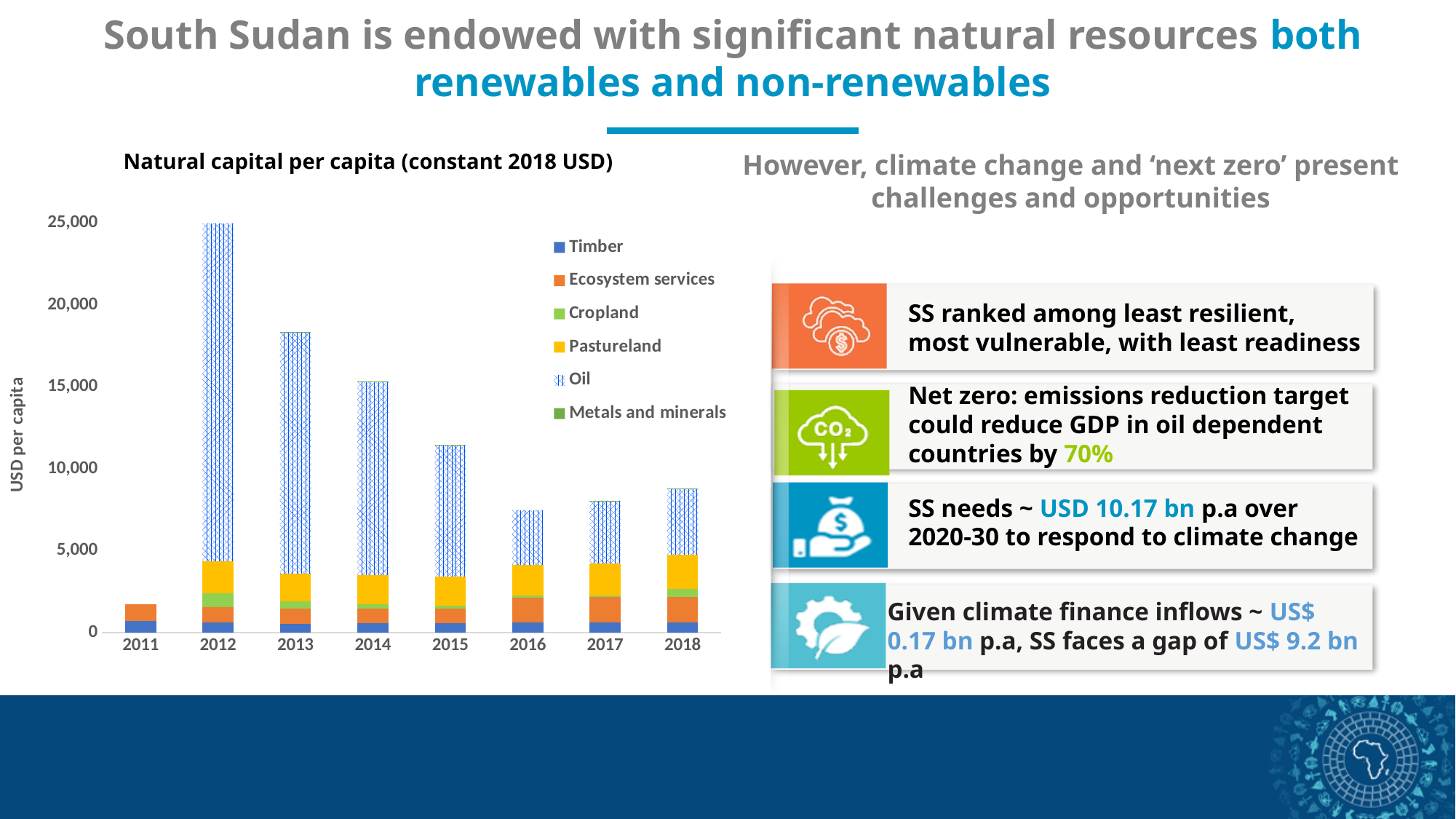
Which year has a larger total natural capital per capita, 2013 or 2014? 2013 Is the total natural capital per capita for 2016 greater or less than 10,000? less What is the label on the y axis of the chart? USD per capita Is the total natural capital per capita for 2012 greater or less than 20,000? greater Is the total natural capital per capita for 2015 greater or less than 10,000? greater How many years are shown on the x axis of the natural capital per capita chart? 8 How many series does the legend of the natural capital per capita chart list? 6 What kind of chart is shown on the slide? Stacked bar chart Does the total natural capital per capita rise or fall from 2012 to 2016? Fall Which year has the lowest total natural capital per capita? 2011 Which year has the highest total natural capital per capita? 2012